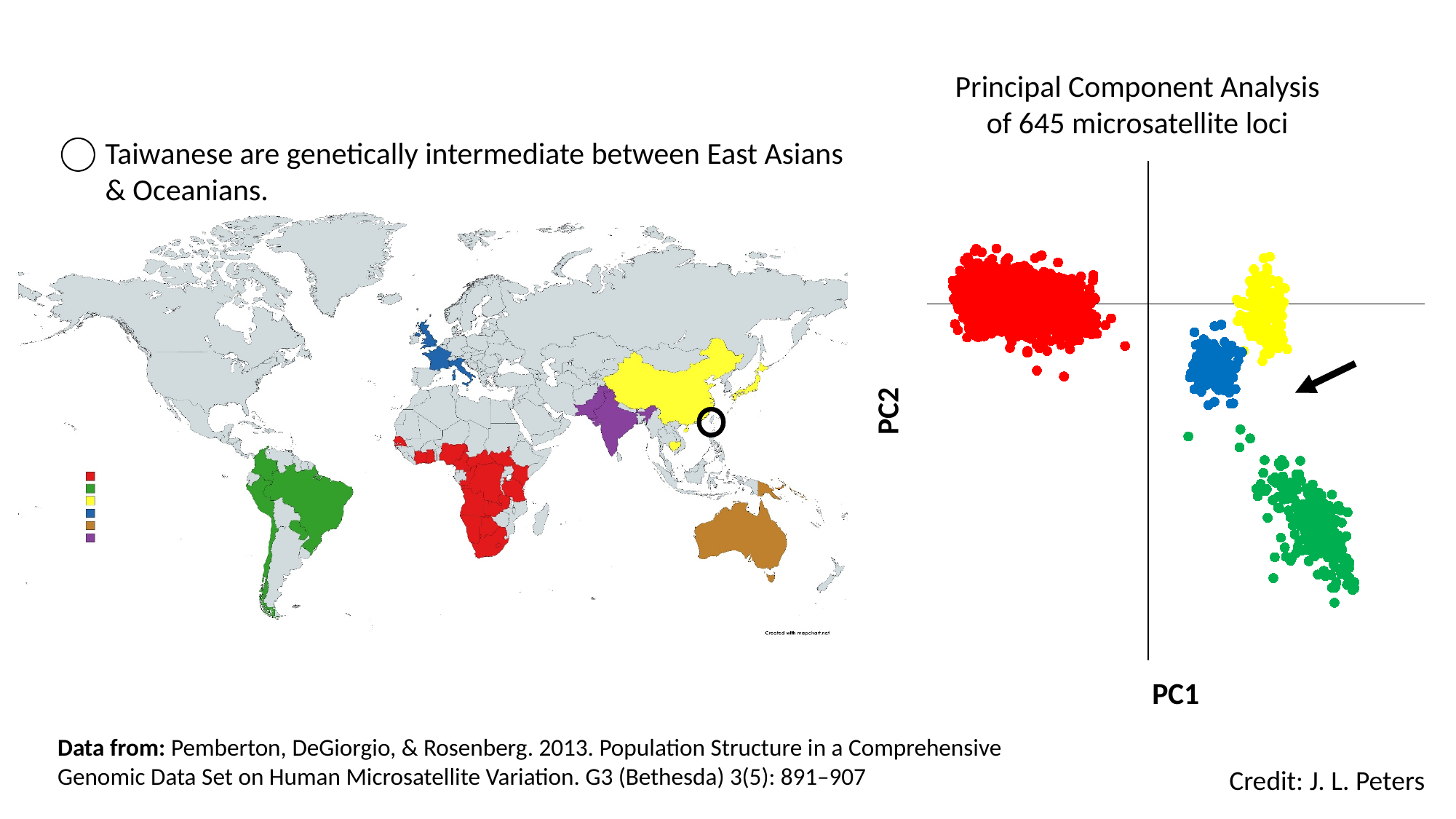
In the PCA scatter plot, which coloured cluster lies furthest to the right along PC1? green In the PCA scatter plot, is the blue cluster's PC1 value greater or less than 0? greater In the PCA scatter plot, is the red cluster's PC1 value greater or less than 0? less In the PCA scatter plot, which cluster is higher along PC2, the blue cluster or the green cluster? blue How many differently coloured clusters of points are plotted in the PCA scatter plot? 4 In the PCA scatter plot, which coloured cluster lies furthest to the left along PC1? red In the PCA scatter plot, which cluster is further right along PC1, the red cluster or the yellow cluster? yellow In the PCA scatter plot, is the green cluster's PC2 value greater or less than 0? less In the PCA scatter plot, which coloured cluster lies lowest along PC2? green What is the title of the chart on the right of the slide? Principal Component Analysis of 645 microsatellite loci What kind of chart is the Principal Component Analysis chart on the right of the slide? scatter plot What are the labels of the horizontal and vertical axes of the PCA scatter plot? PC1 and PC2